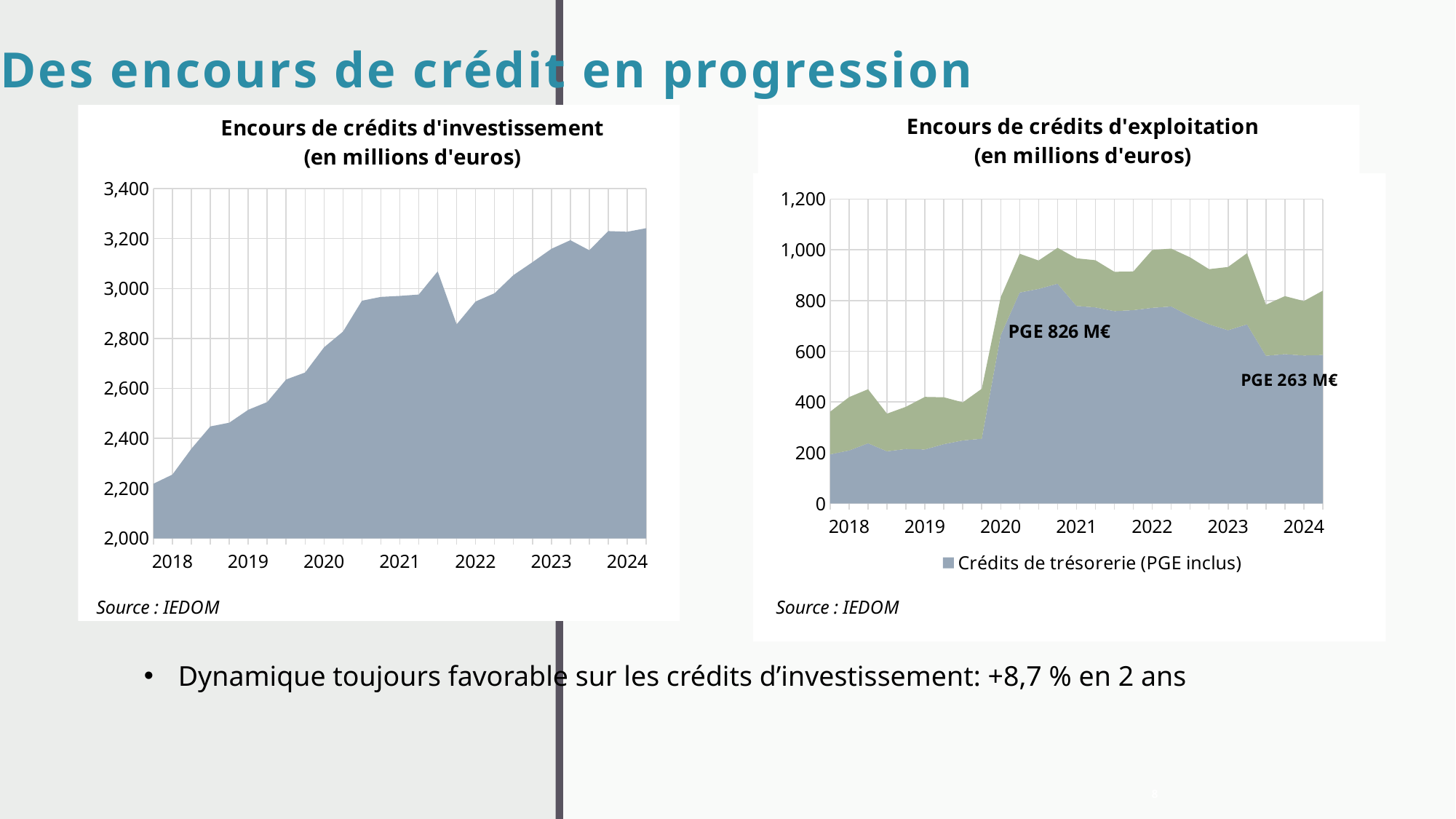
What kind of chart is the 'Encours de crédits d'investissement' chart on the left? Area chart In the 'Encours de crédits d'investissement' chart, do the values generally rise or fall from 2018 to 2024? Rise What kind of chart is the 'Encours de crédits d'exploitation' chart on the right? Stacked area chart What is the source cited below both charts? IEDOM In the 'Encours de crédits d'exploitation' chart, is the 'Crédits de trésorerie (PGE inclus)' value at 2018 greater or less than 400? less In the 'Encours de crédits d'exploitation' chart, what PGE amount is annotated around 2020-2021? PGE 826 M€ In the 'Encours de crédits d'investissement' chart, is the value at the start of 2018 greater or less than 2,400? less In the 'Encours de crédits d'investissement' chart, is the value at 2024 greater or less than 3,000? greater How many year labels appear on the x axis of the 'Encours de crédits d'investissement' chart? 7 How many series does the legend of the 'Encours de crédits d'exploitation' chart list? 1 In the 'Encours de crédits d'exploitation' chart, what PGE amount is annotated near 2024? PGE 263 M€